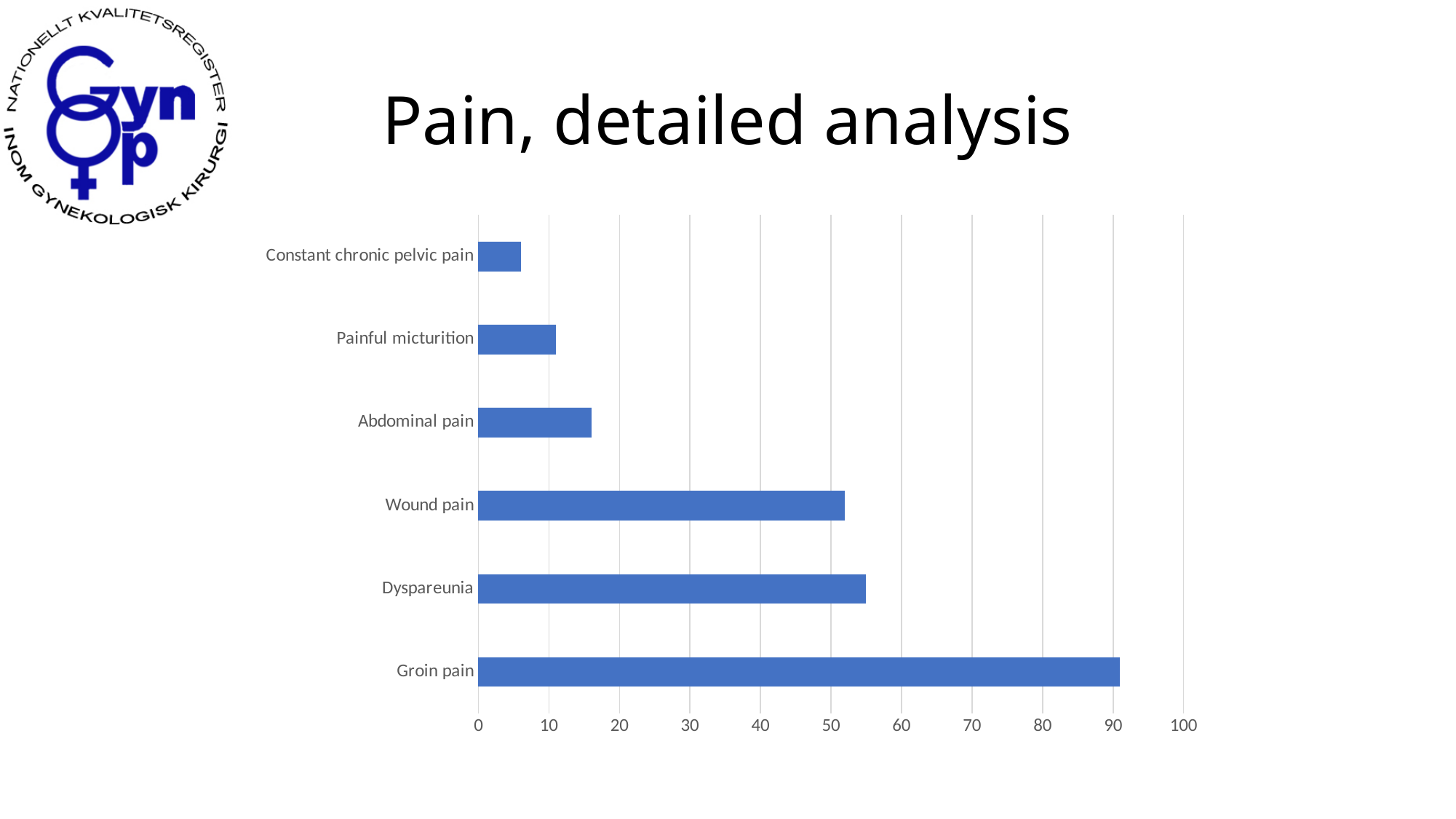
Is the value for Wound pain greater or less than 60? less What kind of chart is shown on the slide? bar chart Is the value for Abdominal pain greater or less than 10? greater Which is larger, the value for Groin pain or the value for Abdominal pain? Groin pain Is the value for Constant chronic pelvic pain greater or less than 10? less Which category has the highest value in the chart? Groin pain How many pain categories are plotted in the chart? 6 What is the title of the slide containing the chart? Pain, detailed analysis Which category has the lowest value in the chart? Constant chronic pelvic pain